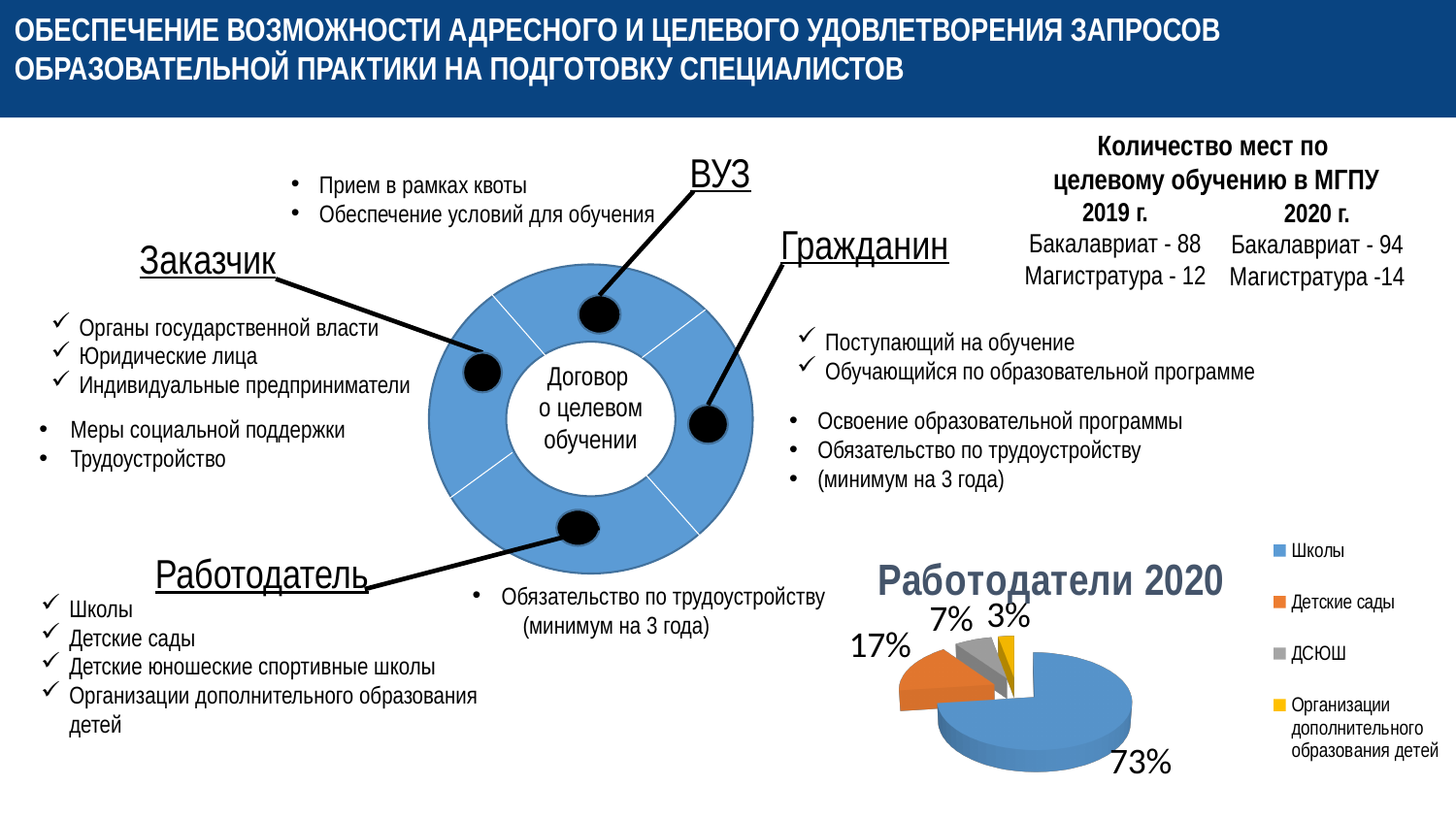
In the "Работодатели 2020" pie chart, what is the difference in percentage points between Школы and Детские сады? 56 Which category has the largest slice in the "Работодатели 2020" pie chart? Школы How many entries does the legend of the "Работодатели 2020" pie chart list? 4 What kind of chart is "Работодатели 2020"? pie chart In the "Работодатели 2020" pie chart, what share does ДСЮШ have? 7% Which category has the smallest slice in the "Работодатели 2020" pie chart? Организации дополнительного образования детей In the "Работодатели 2020" pie chart, what share do Детские сады have? 17% What colour is the Школы slice in the "Работодатели 2020" pie chart? blue In the "Работодатели 2020" pie chart, which is larger: Детские сады or ДСЮШ? Детские сады In the "Работодатели 2020" pie chart, what share do Организации дополнительного образования детей have? 3% How many slices does the "Работодатели 2020" pie chart have? 4 In the "Работодатели 2020" pie chart, what share do Школы have? 73%